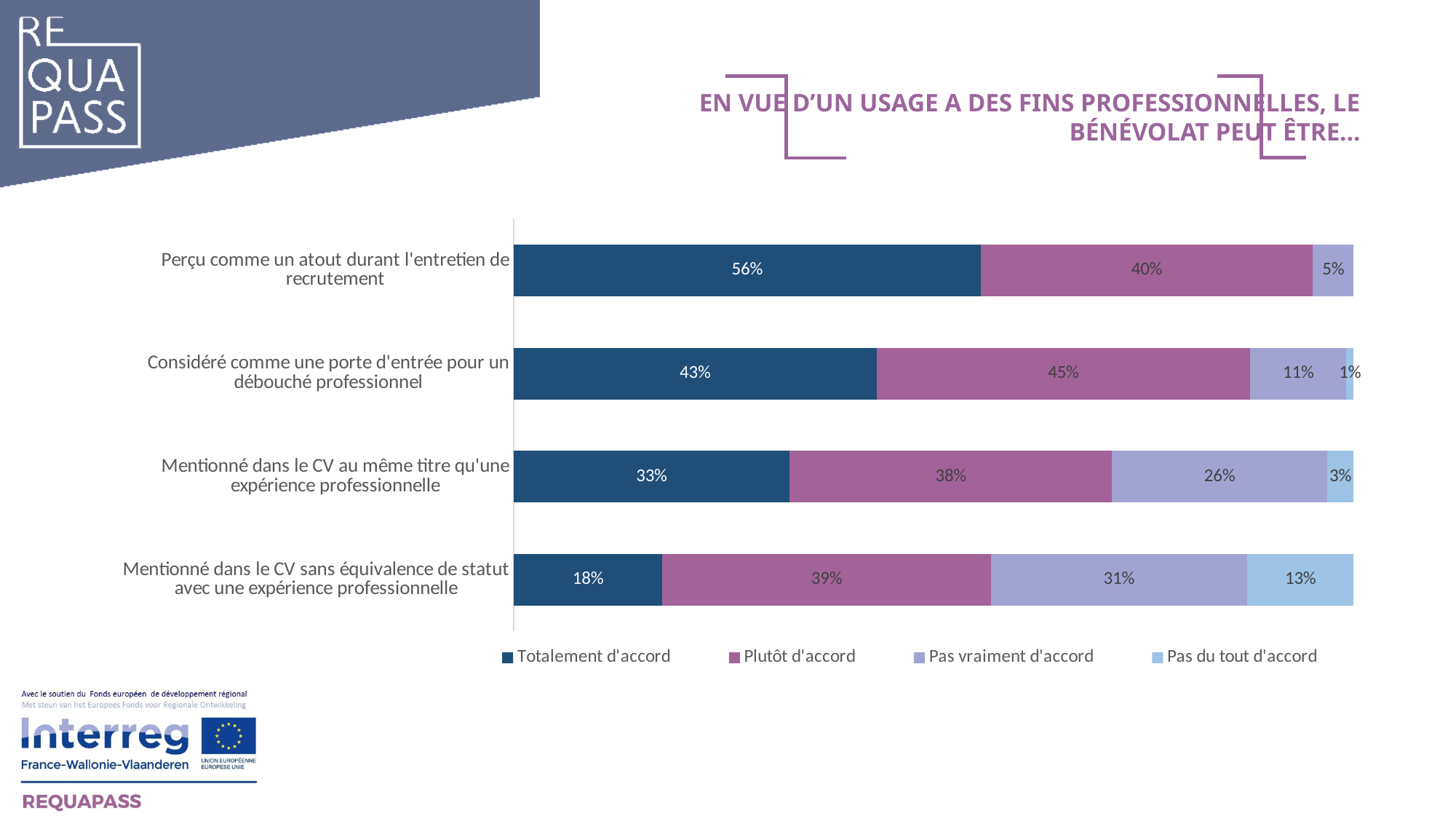
How many categories are plotted on the chart? 4 How many series does the legend list? 4 Which category has the lowest 'Totalement d'accord' value? Mentionné dans le CV sans équivalence de statut avec une expérience professionnelle Which category has the highest 'Totalement d'accord' value? Perçu comme un atout durant l'entretien de recrutement What is the 'Totalement d'accord' value for 'Perçu comme un atout durant l'entretien de recrutement'? 56% What kind of chart is shown on the slide? Stacked bar chart What is the 'Pas du tout d'accord' value for 'Mentionné dans le CV sans équivalence de statut avec une expérience professionnelle'? 13% Which is larger for 'Mentionné dans le CV sans équivalence de statut avec une expérience professionnelle': the 'Plutôt d'accord' value or the 'Pas vraiment d'accord' value? Plutôt d'accord What is the total of the stacked bar for 'Mentionné dans le CV au même titre qu'une expérience professionnelle'? 100% What is the 'Plutôt d'accord' value for 'Considéré comme une porte d'entrée pour un débouché professionnel'? 45% What is the 'Pas vraiment d'accord' value for 'Mentionné dans le CV au même titre qu'une expérience professionnelle'? 26% What is the difference between the 'Totalement d'accord' values for 'Perçu comme un atout durant l'entretien de recrutement' and 'Considéré comme une porte d'entrée pour un débouché professionnel'? 13%